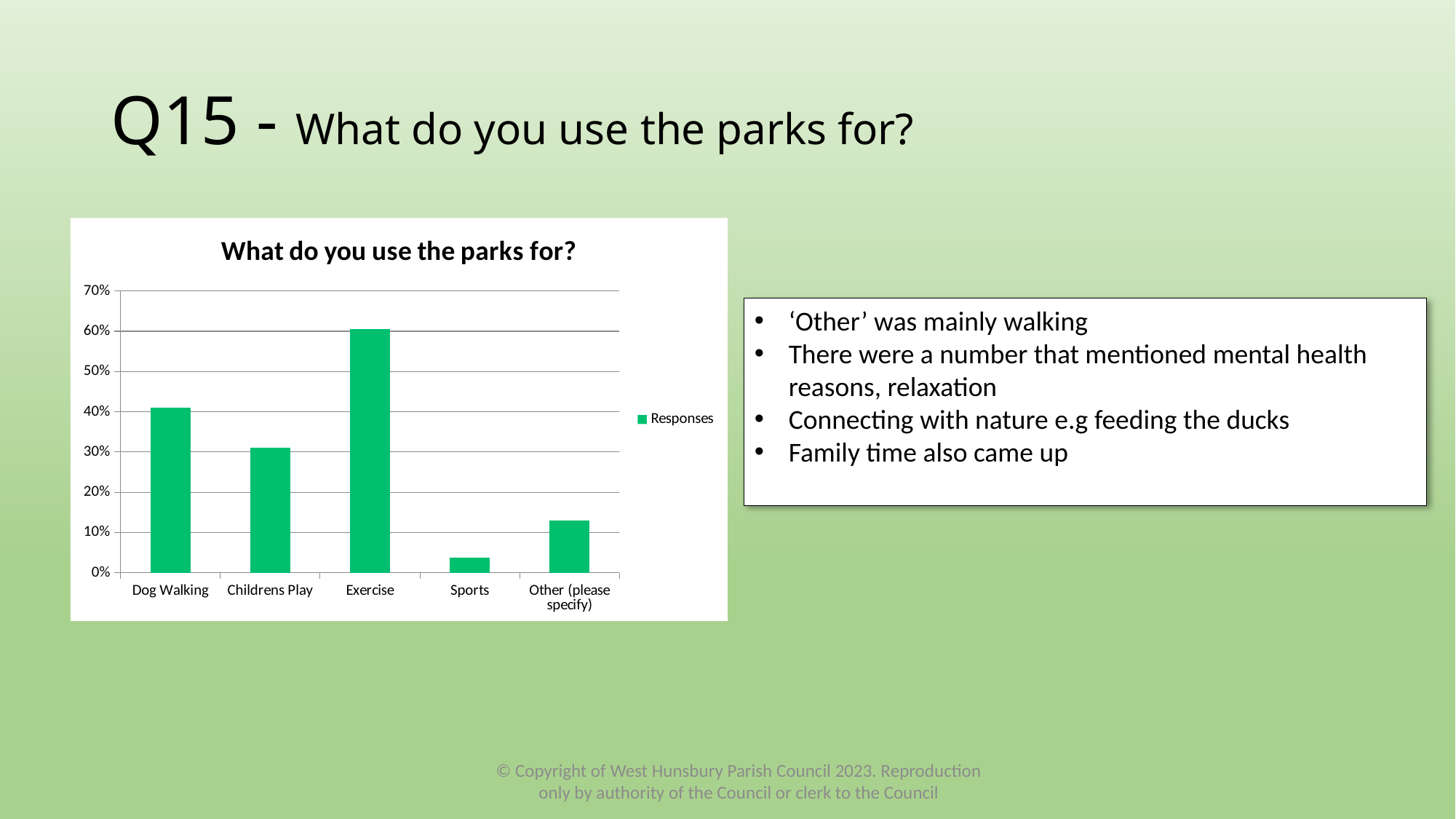
Which is larger, the value for Dog Walking or the value for Childrens Play? Dog Walking How many categories are shown on the x axis of the chart? 5 What is the name of the series shown in the chart legend? Responses Which category has the highest value in the chart? Exercise Is the value for Dog Walking greater or less than 50%? less Which category has the lowest value in the chart? Sports Which is larger, the value for Sports or the value for Other (please specify)? Other (please specify) Is the value for Sports greater or less than 10%? less What kind of chart is shown on the slide? bar chart Is the value for Exercise greater or less than 50%? greater What is the title of the chart? What do you use the parks for? How many series does the chart legend list? 1